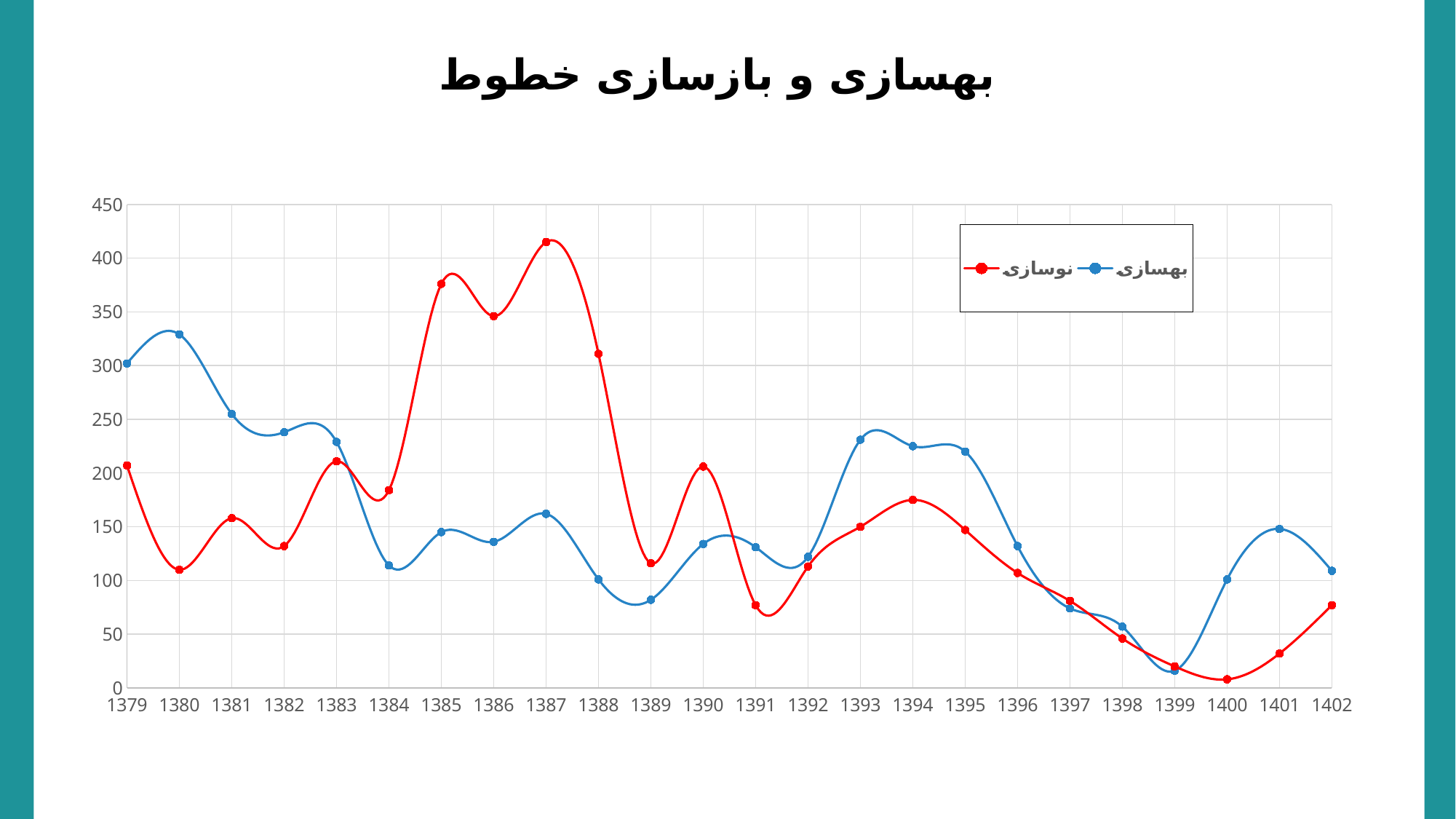
How many series does the legend list? 2 In which year does the بهسازی (blue) series reach its lowest value? 1399 In which year does the نوسازی (red) series reach its lowest value? 1400 In 1380, which series has the larger value, نوسازی or بهسازی? بهسازی How many years are plotted along the x axis? 24 In which year does the بهسازی (blue) series reach its highest value? 1380 Is the بهسازی (blue) value for 1384 greater or less than 150? less Is the نوسازی (red) value for 1385 greater or less than 350? greater In which year does the نوسازی (red) series reach its highest value? 1387 In 1387, which series has the larger value, نوسازی or بهسازی? نوسازی What is the title of the chart? بهسازی و بازسازی خطوط What kind of chart is shown on the slide? line chart